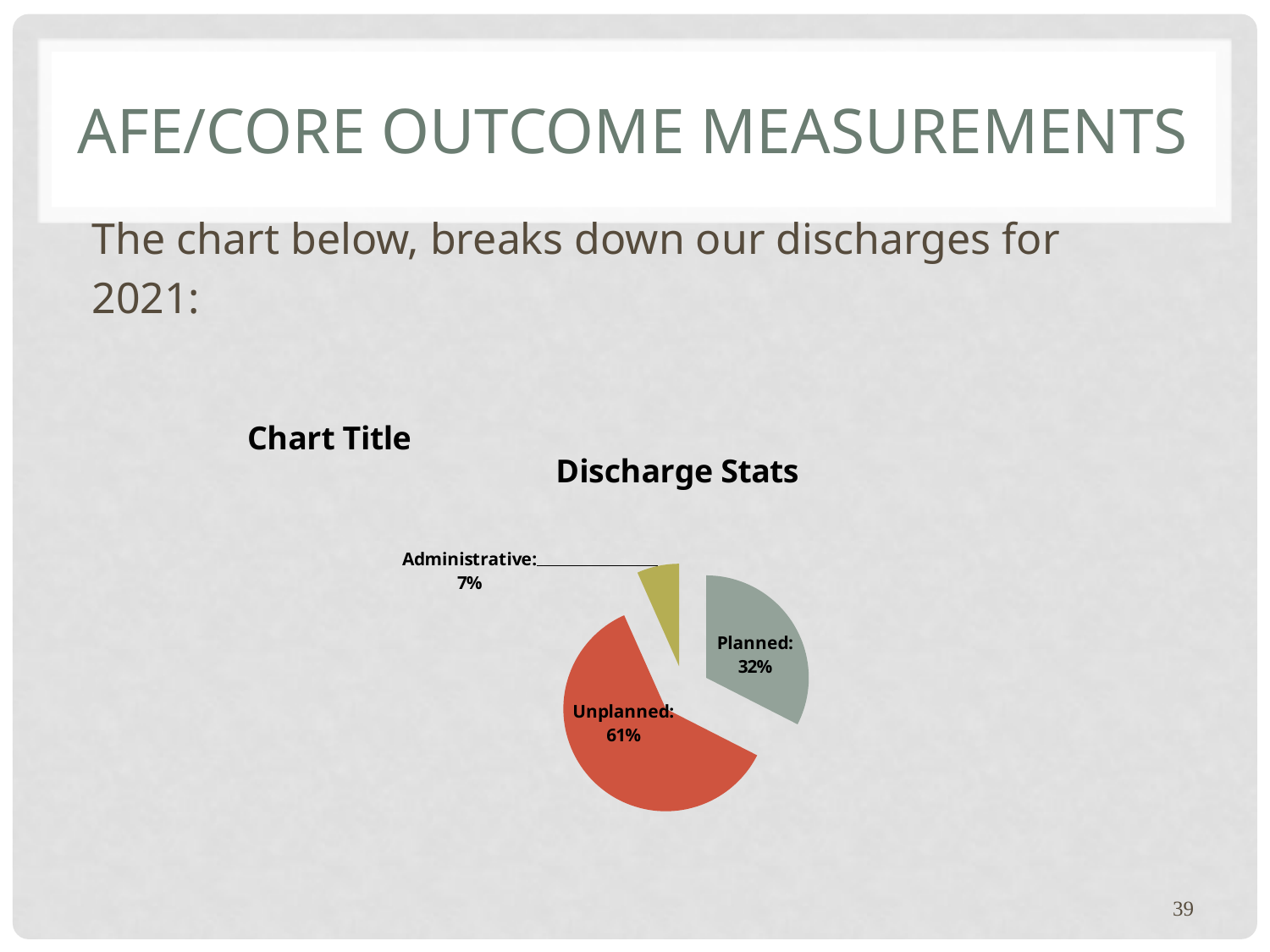
Which is larger, the Planned share or the Administrative share? Planned What percentage of discharges were Administrative? 7% What is the title shown above the pie chart? Discharge Stats How many slices does the pie chart have? 3 What is the difference in percentage points between Unplanned and Planned discharges? 29 What percentage of discharges were Unplanned? 61% What kind of chart is shown on the slide? pie chart What is the difference in percentage points between Planned and Administrative discharges? 25 Which discharge category has the smallest share of the pie? Administrative What percentage of discharges were Planned? 32% What colour is the Unplanned slice of the pie? red Which discharge category has the largest share of the pie? Unplanned